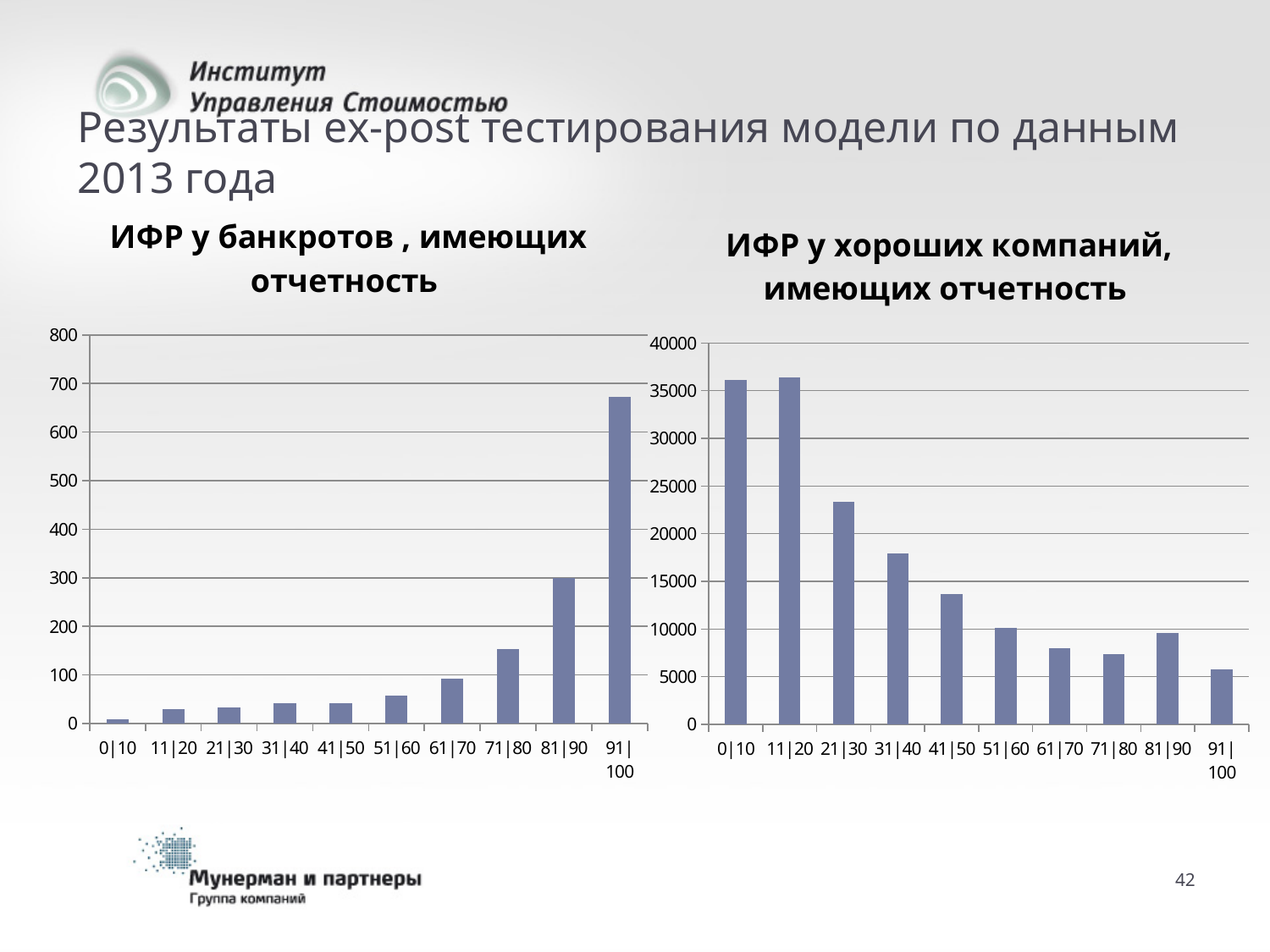
How many categories are shown on the x axis of the right chart, 'ИФР у хороших компаний, имеющих отчетность'? 10 In the left chart, 'ИФР у банкротов, имеющих отчетность', which category has the lowest value? 0|10 In the right chart, 'ИФР у хороших компаний, имеющих отчетность', which category has the lowest value? 91|100 In the left chart, 'ИФР у банкротов, имеющих отчетность', which is larger: the value for 71|80 or the value for 81|90? 81|90 In the left chart, 'ИФР у банкротов, имеющих отчетность', is the value for 91|100 greater or less than 600? greater In the left chart, 'ИФР у банкротов, имеющих отчетность', is the value for 81|90 greater or less than 200? greater In the right chart, 'ИФР у хороших компаний, имеющих отчетность', which is larger: the value for 31|40 or the value for 41|50? 31|40 In the right chart, 'ИФР у хороших компаний, имеющих отчетность', is the value for 21|30 greater or less than 20000? greater What kind of chart is the left chart, 'ИФР у банкротов, имеющих отчетность'? bar chart In the left chart, 'ИФР у банкротов, имеющих отчетность', do the values generally rise or fall from 0|10 to 91|100? rise In the left chart, 'ИФР у банкротов, имеющих отчетность', which category has the highest value? 91|100